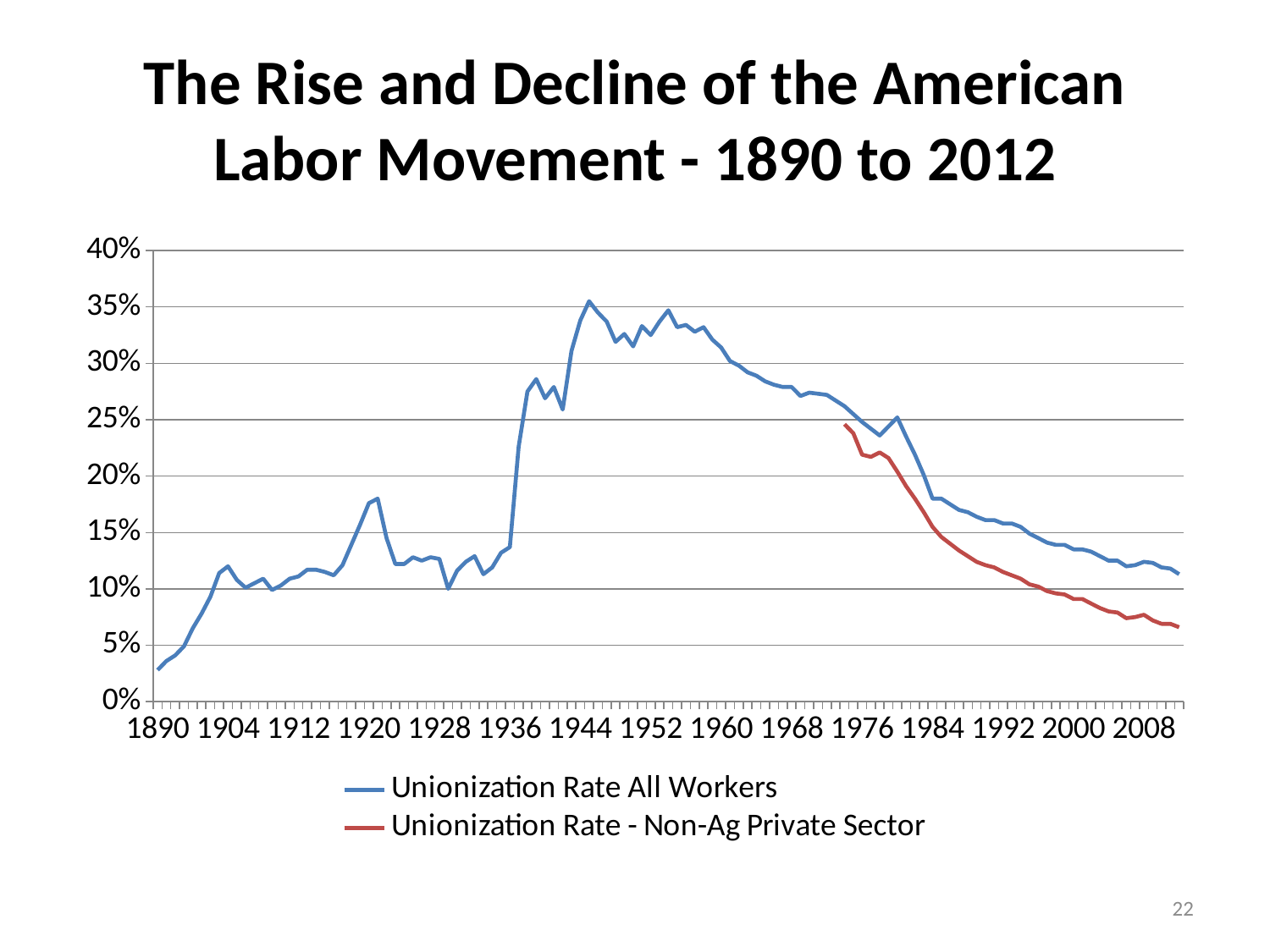
How many series does the legend list? 2 Does the Unionization Rate All Workers series rise or fall between 1976 and 2008? Fall Is the value for Unionization Rate All Workers in 1968 greater or less than 25%? greater Is the value for Unionization Rate All Workers in 2008 greater or less than 10%? greater Is the value for Unionization Rate All Workers in 1890 greater or less than 5%? less Does the Unionization Rate All Workers series rise or fall between 1890 and 1904? Rise What kind of chart is shown on the slide? Line chart What is the title of the chart on the slide? The Rise and Decline of the American Labor Movement - 1890 to 2012 Which series is drawn in red? Unionization Rate - Non-Ag Private Sector In 2008, which series has the higher value: Unionization Rate All Workers or Unionization Rate - Non-Ag Private Sector? Unionization Rate All Workers